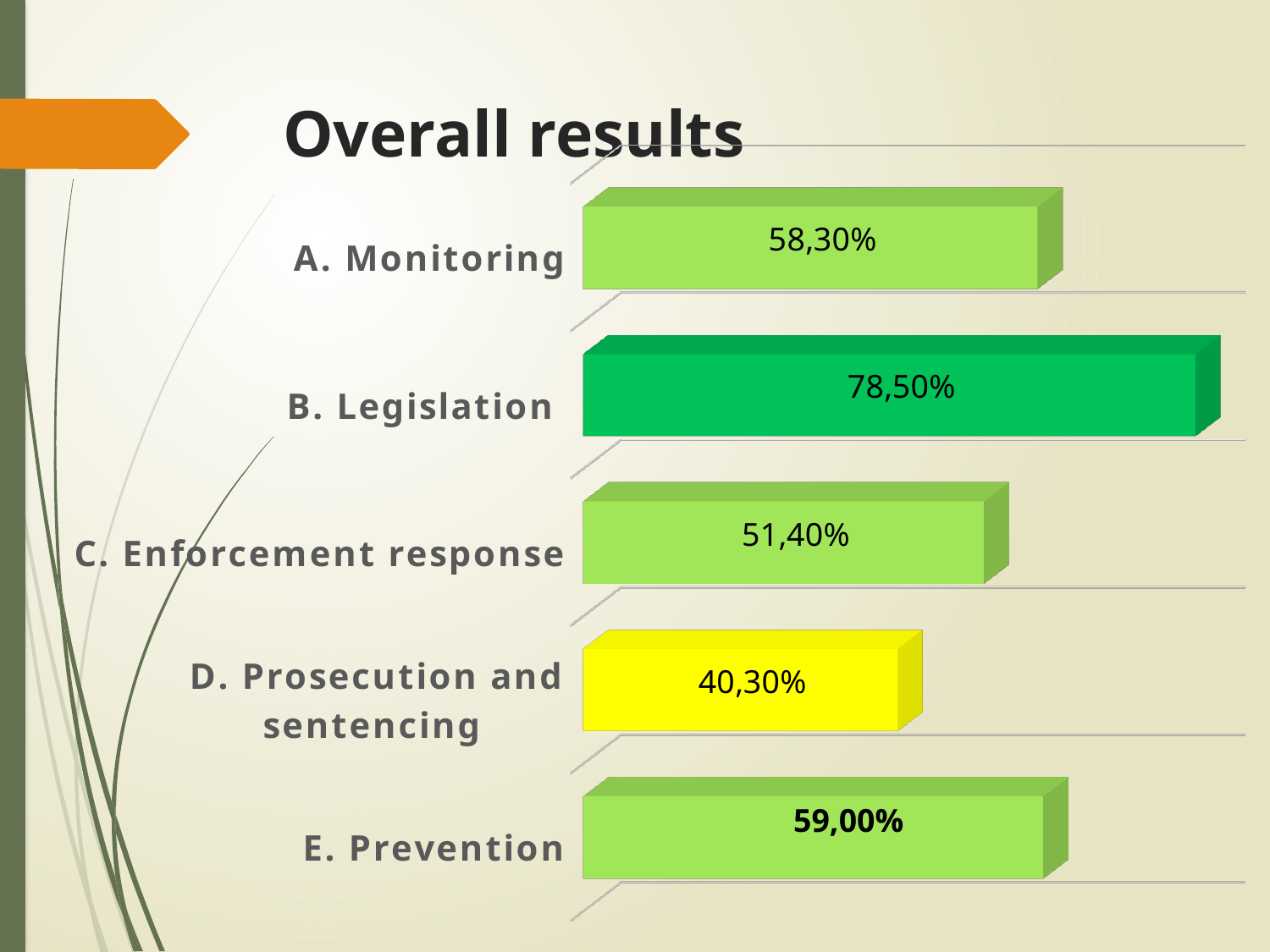
What is the value for B. Legislation? 78,50% Which category has the lowest value? D. Prosecution and sentencing Which is larger, the value for B. Legislation or the value for C. Enforcement response? B. Legislation What is the title of the slide? Overall results What is the difference between the values for B. Legislation and D. Prosecution and sentencing? 38,20% How many categories are shown in the chart? 5 What is the value for E. Prevention? 59,00% Which category has the highest value? B. Legislation What is the value for D. Prosecution and sentencing? 40,30% What is the difference between the values for A. Monitoring and C. Enforcement response? 6,90% What is the value for C. Enforcement response? 51,40% What kind of chart is shown on the slide? Bar chart